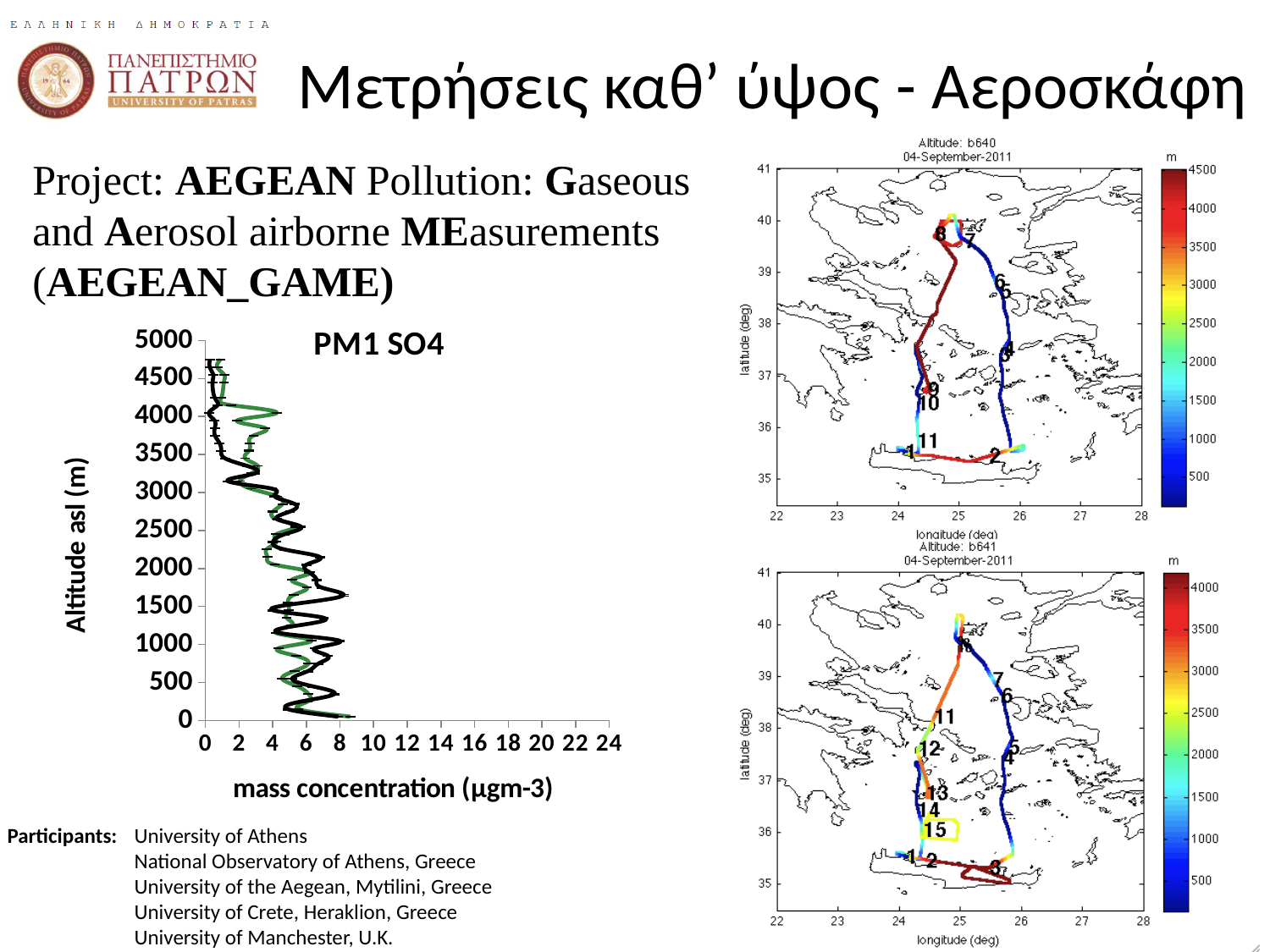
In the PM1 SO4 chart, is the mass concentration of the black line at about 3000 m altitude greater or less than 6? less What kind of chart is the PM1 SO4 chart on the left of the slide? line chart What is the title of the line chart on the left of the slide? PM1 SO4 On the bottom map (Altitude: b641), what is the highest altitude value shown on the colour bar? 4000 How many lines (series) are plotted in the PM1 SO4 chart? 2 What is the x-axis label of the PM1 SO4 chart? mass concentration (μgm-3) In the PM1 SO4 chart, is the mass concentration at about 4500 m altitude greater or less than 4? less In the PM1 SO4 chart, what is the highest altitude tick shown on the y-axis? 5000 In the PM1 SO4 chart, what is the largest value shown on the x-axis? 24 On the top map (Altitude: b640), what is the highest altitude value shown on the colour bar? 4500 In the PM1 SO4 chart, does the mass concentration generally rise or fall as altitude increases from 0 m to 4500 m? fall In the PM1 SO4 chart, is the mass concentration of the black line near 0 m altitude greater or less than 6? greater